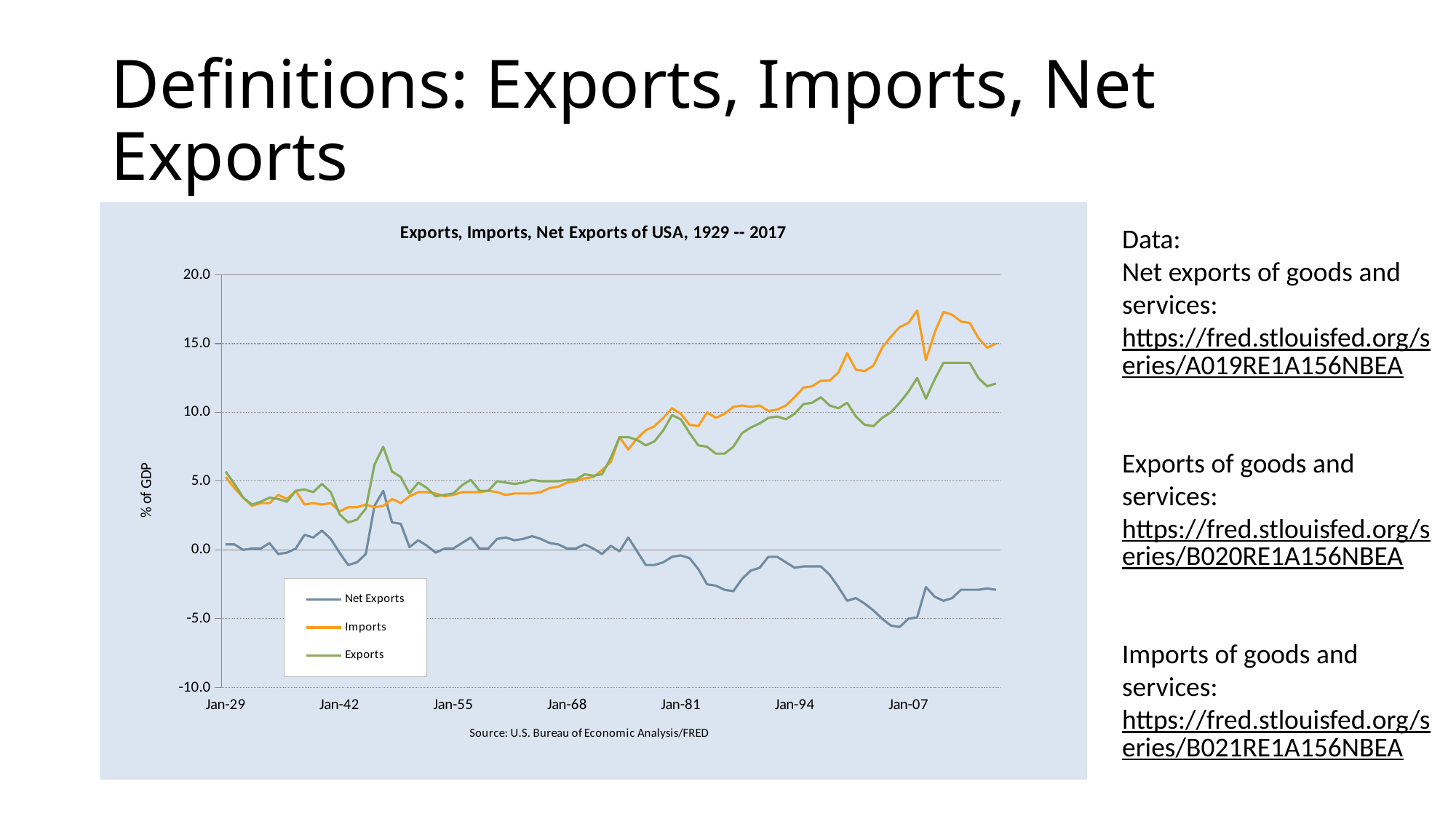
Does the Imports series generally rise or fall from Jan-29 to 2017? rise What is the title of the chart? Exports, Imports, Net Exports of USA, 1929 -- 2017 Is the value of Net Exports at the right end of the chart (2017) greater or less than 0.0? less What kind of chart is shown on the slide? line chart Which series has the lowest values at the right end of the chart? Net Exports How many series does the chart legend list? 3 Is the lowest value of the Net Exports series greater or less than -5.0? less Is the value of Exports at the right end of the chart (2017) greater or less than 10.0? greater Does the Net Exports series generally rise or fall from Jan-68 to 2017? fall What is the label on the vertical axis of the chart? % of GDP Around Jan-07, which series is higher: Imports or Exports? Imports